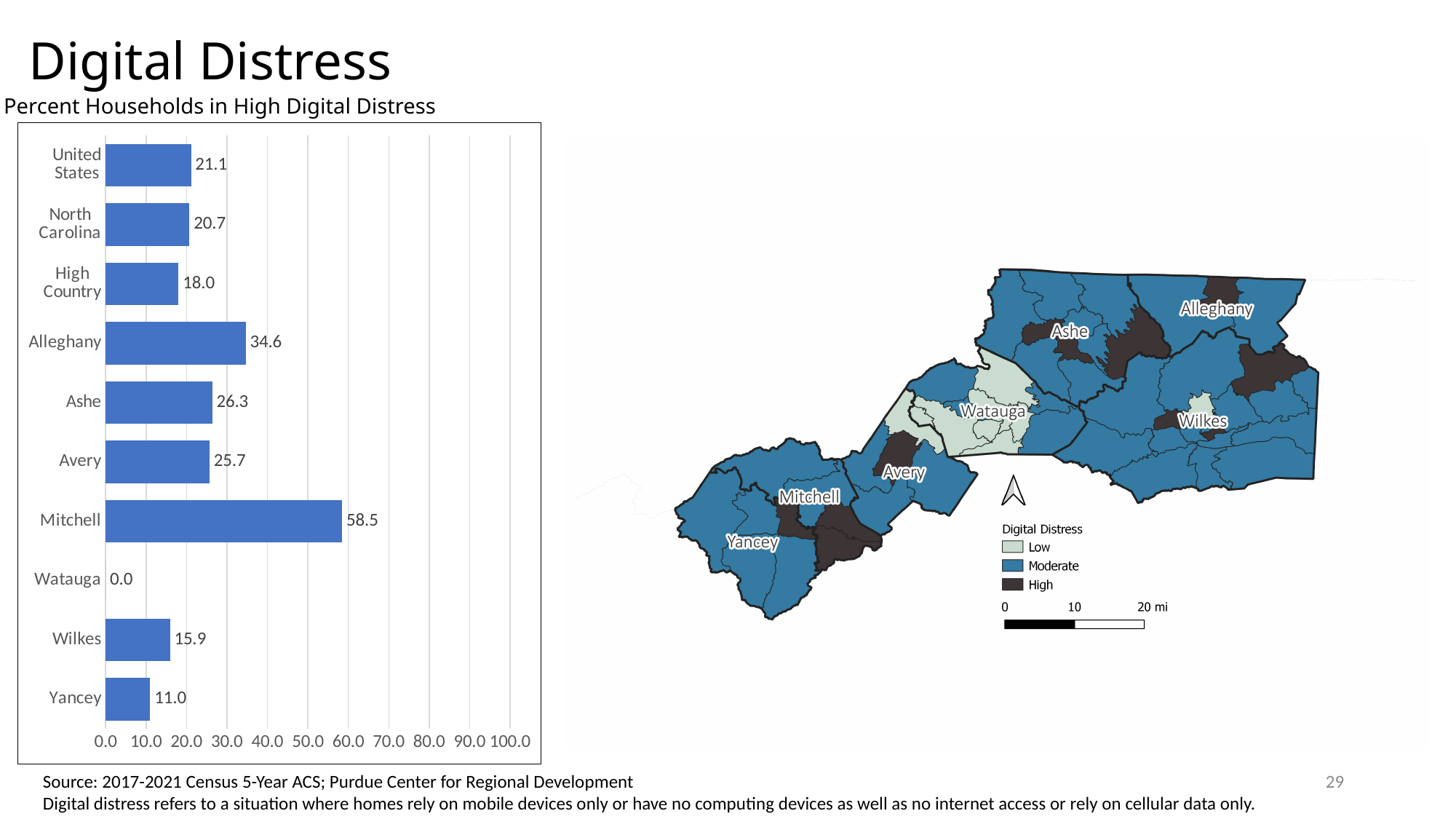
How many categories are shown in the bar chart? 10 Which category has the highest value in the bar chart? Mitchell Which is larger in the bar chart, the value for Wilkes or the value for Yancey? Wilkes What is the value for the United States in the bar chart? 21.1 What kind of chart is used to show Percent Households in High Digital Distress? Bar chart Which category has the lowest value in the bar chart? Watauga What is the value for Watauga in the bar chart? 0.0 What is the title of the bar chart on the slide? Percent Households in High Digital Distress What is the value for High Country in the bar chart? 18.0 What is the value for Mitchell in the Percent Households in High Digital Distress chart? 58.5 What is the difference between the values for Alleghany and Ashe in the bar chart? 8.3 What is the difference between the values for North Carolina and Avery in the bar chart? 5.0